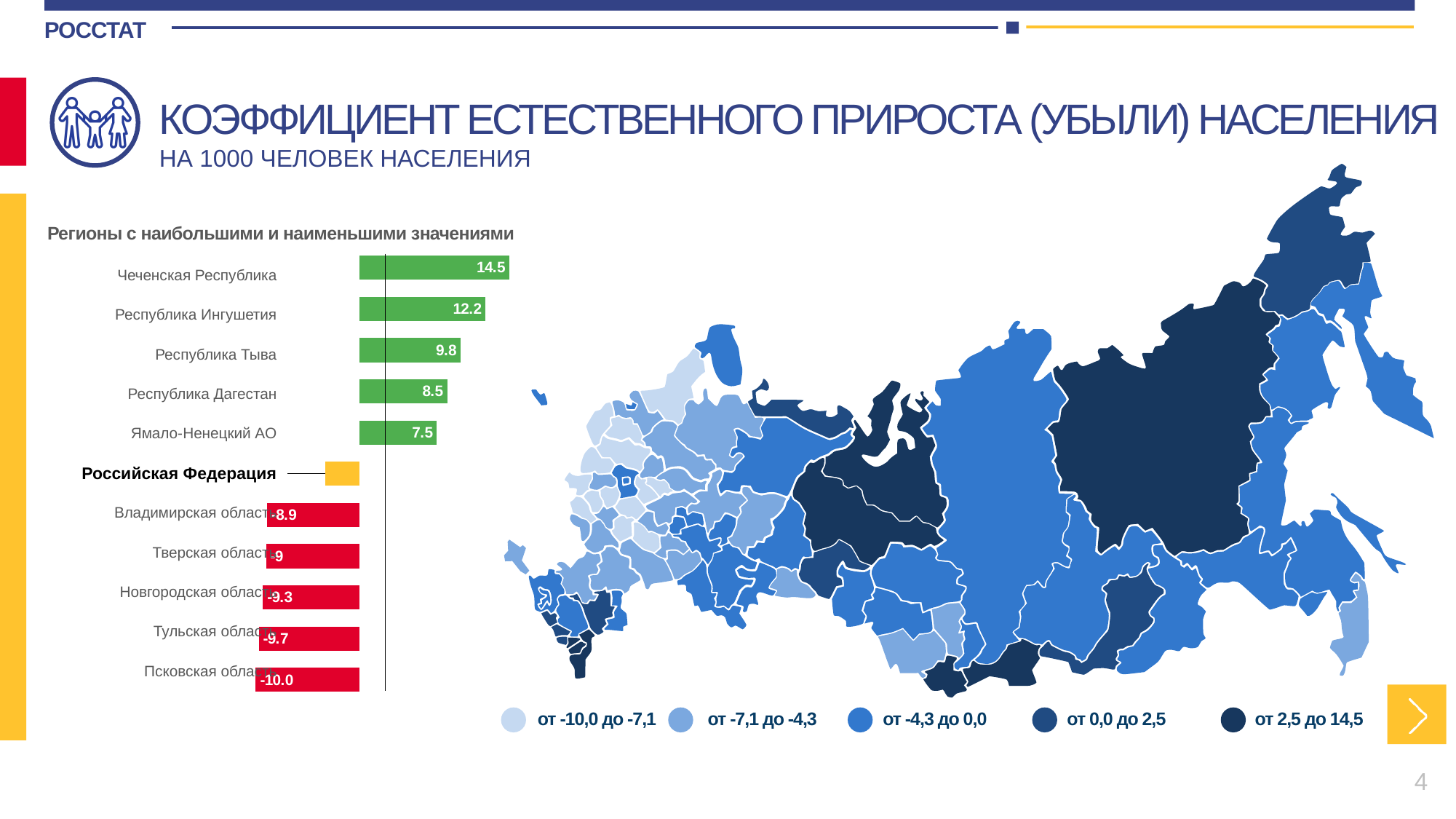
What is the value for Псковская область in the bar chart? -10.0 What is the value for Ямало-Ненецкий АО in the bar chart? 7.5 What colour are the bars for regions with negative values in the bar chart? Red What is the difference between the values for Чеченская Республика and Республика Ингушетия? 2.3 How many value ranges does the map legend list? 5 How many regions (including Российская Федерация) are listed in the bar chart? 11 Which region has the lowest value in the bar chart? Псковская область What is the value for Республика Тыва in the bar chart? 9.8 What is the value for Чеченская Республика in the bar chart? 14.5 Which region has the highest value in the bar chart? Чеченская Республика What kind of chart shows the regions with the highest and lowest values? Bar chart Which has a larger value, Республика Дагестан or Республика Тыва? Республика Тыва